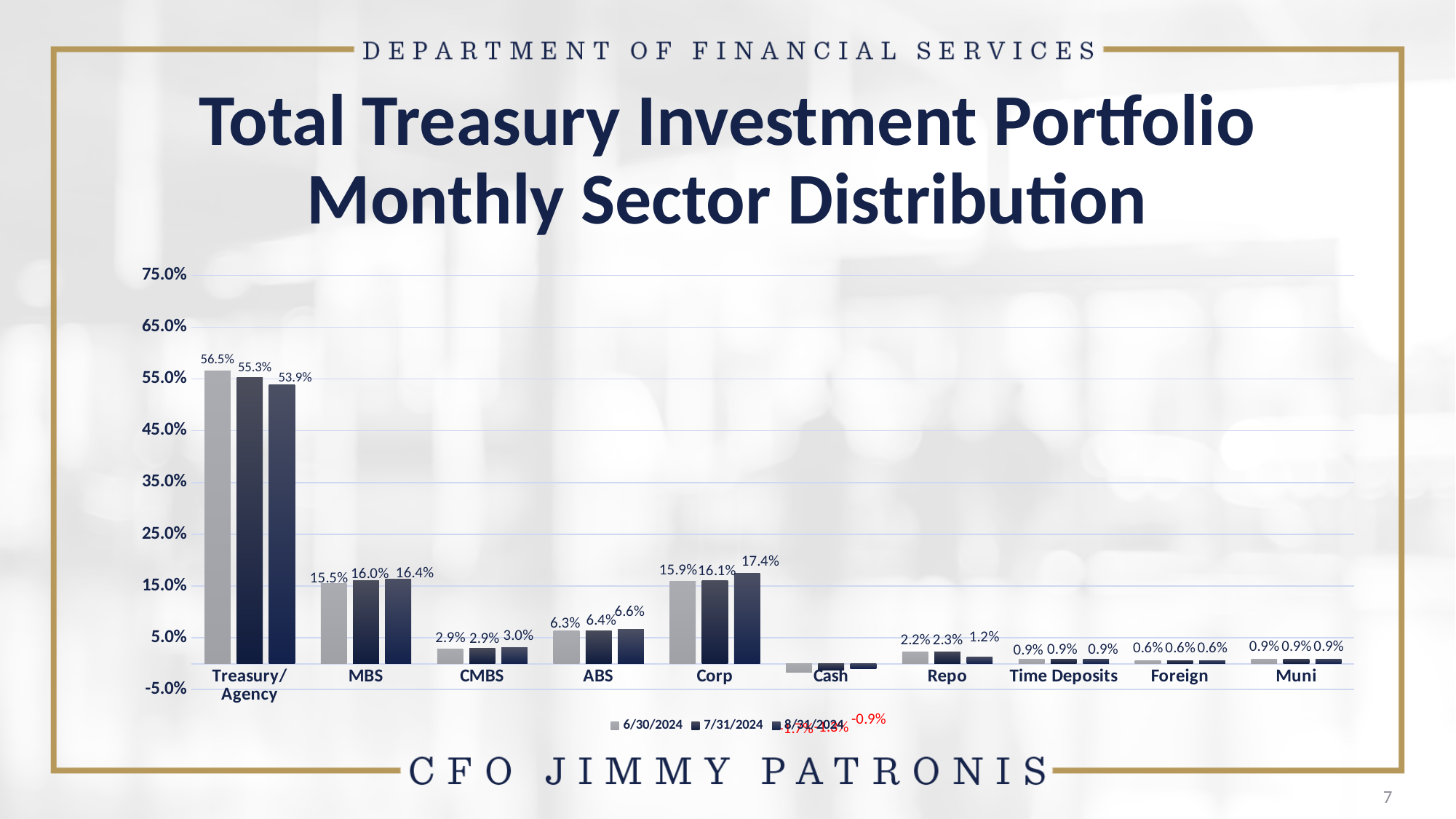
Which sector has the lowest value for 8/31/2024? Cash How many sector categories are shown on the x axis? 10 What is the value for Repo for 8/31/2024? 1.2% Do the Treasury/Agency values rise or fall from 6/30/2024 to 8/31/2024? fall Which is larger for 8/31/2024: MBS or Corp? Corp What kind of chart is shown on the slide? bar chart Which sector has the highest value for 6/30/2024? Treasury/Agency What is the value for Corp for 7/31/2024? 16.1% What is the value for Treasury/Agency for 8/31/2024? 53.9% What is the difference between the Treasury/Agency values for 6/30/2024 and 8/31/2024? 2.6% How many series does the legend list? 3 What is the title of the chart? Total Treasury Investment Portfolio Monthly Sector Distribution